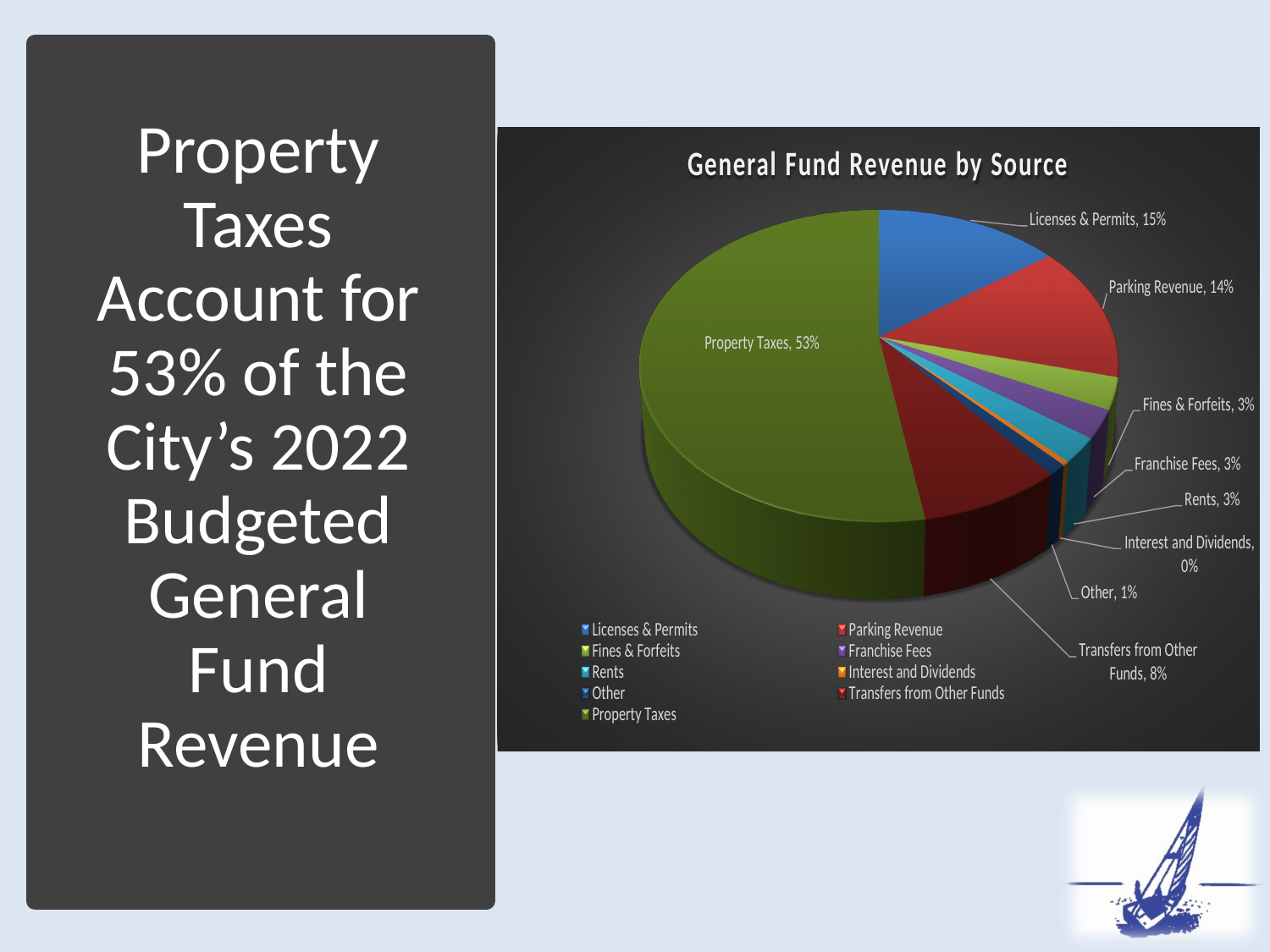
Which revenue source has the smallest share of the pie? Interest and Dividends What share of General Fund Revenue comes from Interest and Dividends? 0% What type of chart is shown on the slide? Pie chart What is the difference in percentage points between Property Taxes and Licenses & Permits? 38 What share of General Fund Revenue comes from Property Taxes? 53% What share of General Fund Revenue comes from Licenses & Permits? 15% Which revenue source has the largest share of the pie? Property Taxes What share of General Fund Revenue comes from Transfers from Other Funds? 8% What share of General Fund Revenue comes from Parking Revenue? 14% How many revenue sources are listed in the chart legend? 9 Which is larger, the share for Licenses & Permits or the share for Transfers from Other Funds? Licenses & Permits What is the title of the chart? General Fund Revenue by Source